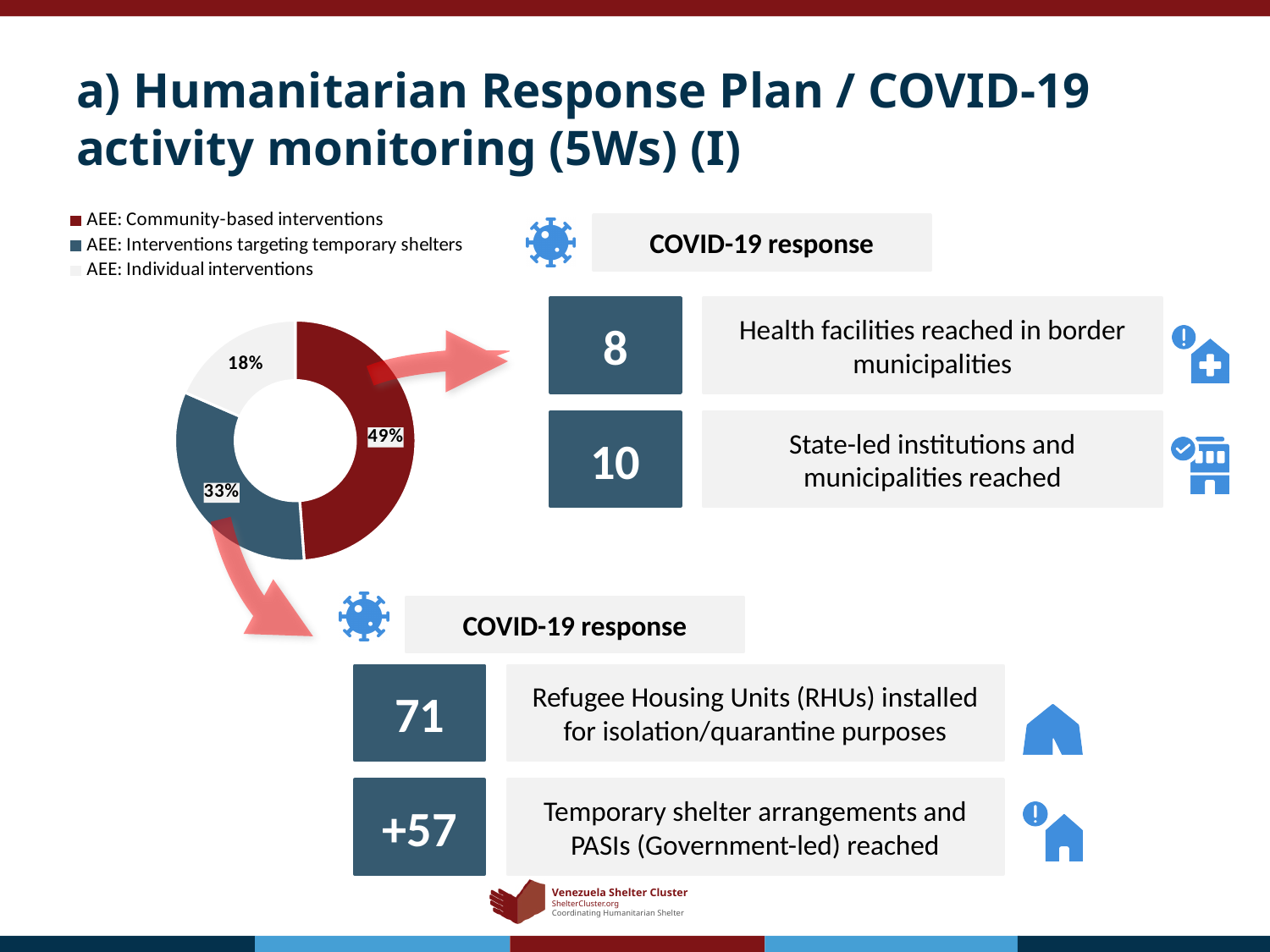
How many slices does the donut chart have? 3 What share of the donut chart is labelled for AEE: Individual interventions? 18% How many entries does the chart legend list? 3 What is the combined share of the Community-based interventions and Interventions targeting temporary shelters slices? 82% Which category has the largest slice in the donut chart? AEE: Community-based interventions What colour is the slice for AEE: Community-based interventions in the donut chart? Dark red What kind of chart is shown on the slide? Donut (pie) chart Which is larger in the donut chart: the slice for Interventions targeting temporary shelters or the slice for Individual interventions? AEE: Interventions targeting temporary shelters Which category has the smallest slice in the donut chart? AEE: Individual interventions What share of the donut chart is labelled for AEE: Community-based interventions? 49% What is the difference in percentage points between the Community-based interventions slice and the Individual interventions slice? 31 percentage points What share of the donut chart is labelled for AEE: Interventions targeting temporary shelters? 33%